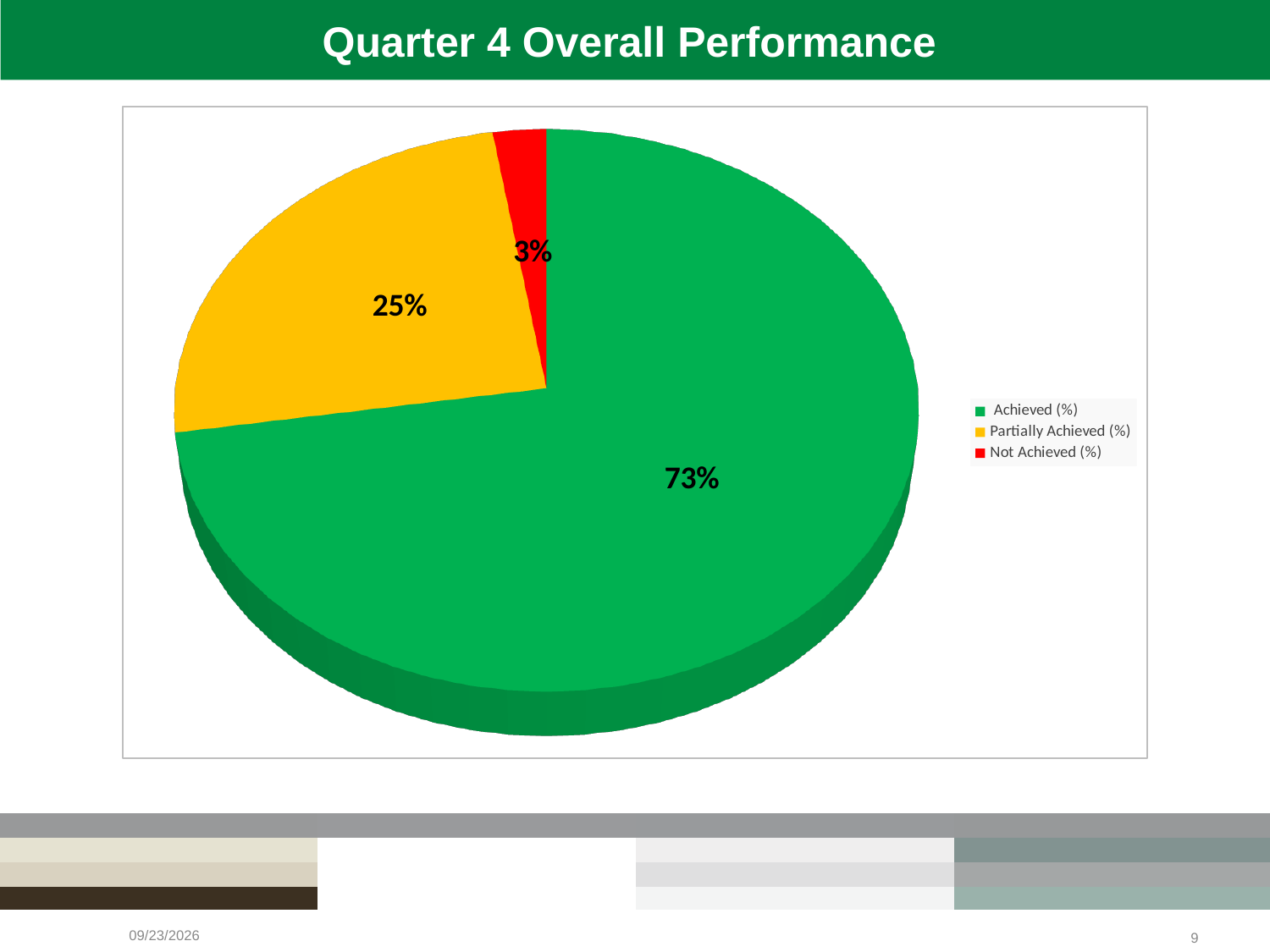
What percentage is shown for Partially Achieved (%)? 25% What colour is the Not Achieved (%) slice? red Which category has the smallest slice of the pie? Not Achieved (%) What is the difference between the Achieved (%) and Partially Achieved (%) values? 48% What percentage is shown for Achieved (%)? 73% What percentage is shown for Not Achieved (%)? 3% What kind of chart is shown on the slide? pie chart What is the title of the slide containing the chart? Quarter 4 Overall Performance What is the difference between the Partially Achieved (%) and Not Achieved (%) values? 22% How many categories does the pie chart show? 3 Which category has the largest slice of the pie? Achieved (%) Which is larger, Partially Achieved (%) or Not Achieved (%)? Partially Achieved (%)